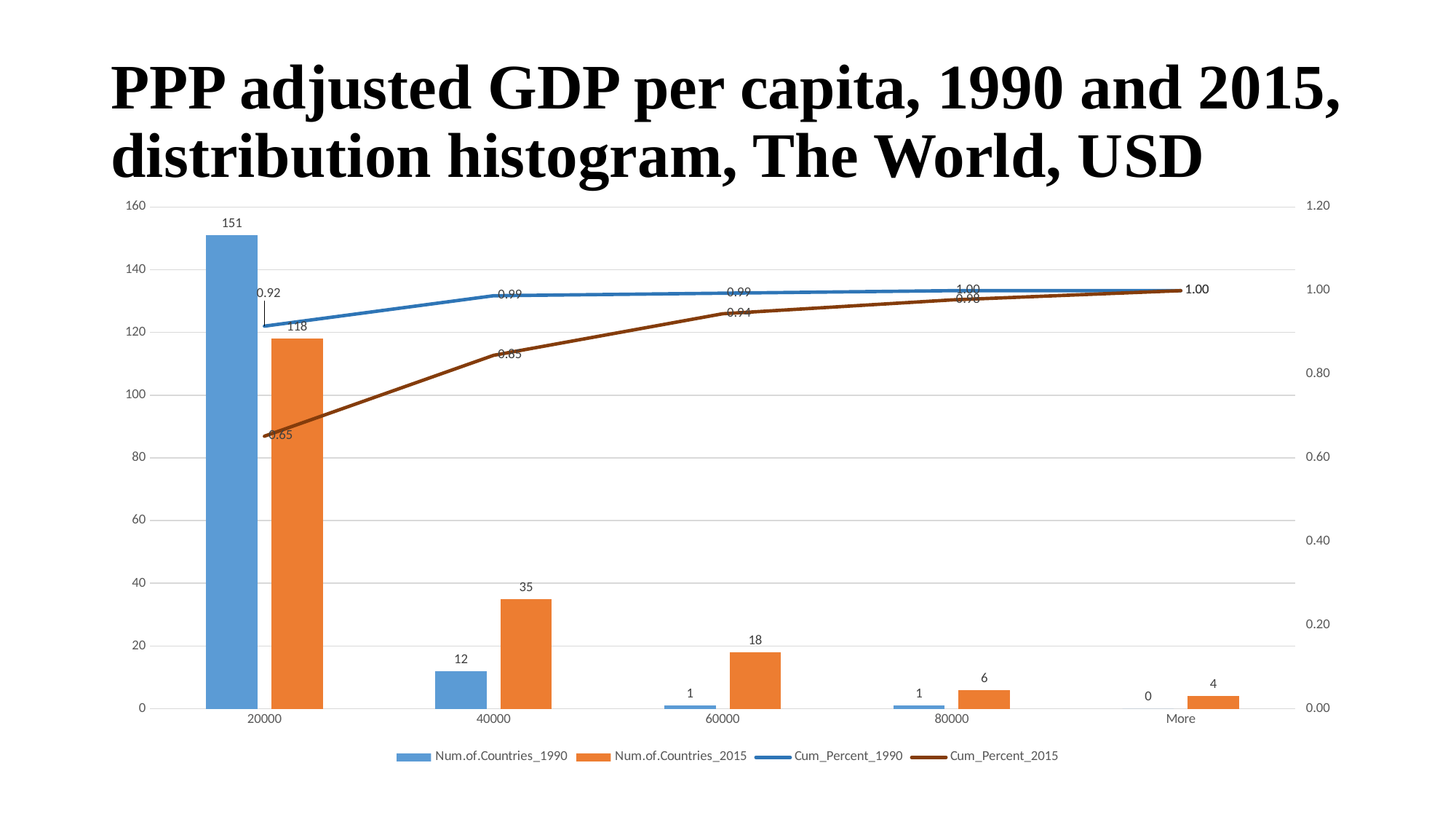
How many series does the legend list? 4 What is the Cum_Percent_1990 value at the 20000 bin? 0.92 What is the value of Num.of.Countries_2015 for the 40000 bin? 35 Which bin has the lowest value for Num.of.Countries_1990? More Does the Cum_Percent_2015 line rise or fall from the 20000 bin to the More bin? rise For the 60000 bin, which is larger: Num.of.Countries_1990 or Num.of.Countries_2015? Num.of.Countries_2015 What colour are the Num.of.Countries_2015 bars? orange What is the Cum_Percent_2015 value at the 20000 bin? 0.65 What is the value of Num.of.Countries_1990 for the 20000 bin? 151 Which bin has the highest value for Num.of.Countries_2015? 20000 How many bins are shown on the x axis? 5 What is the difference between Num.of.Countries_1990 and Num.of.Countries_2015 for the 20000 bin? 33